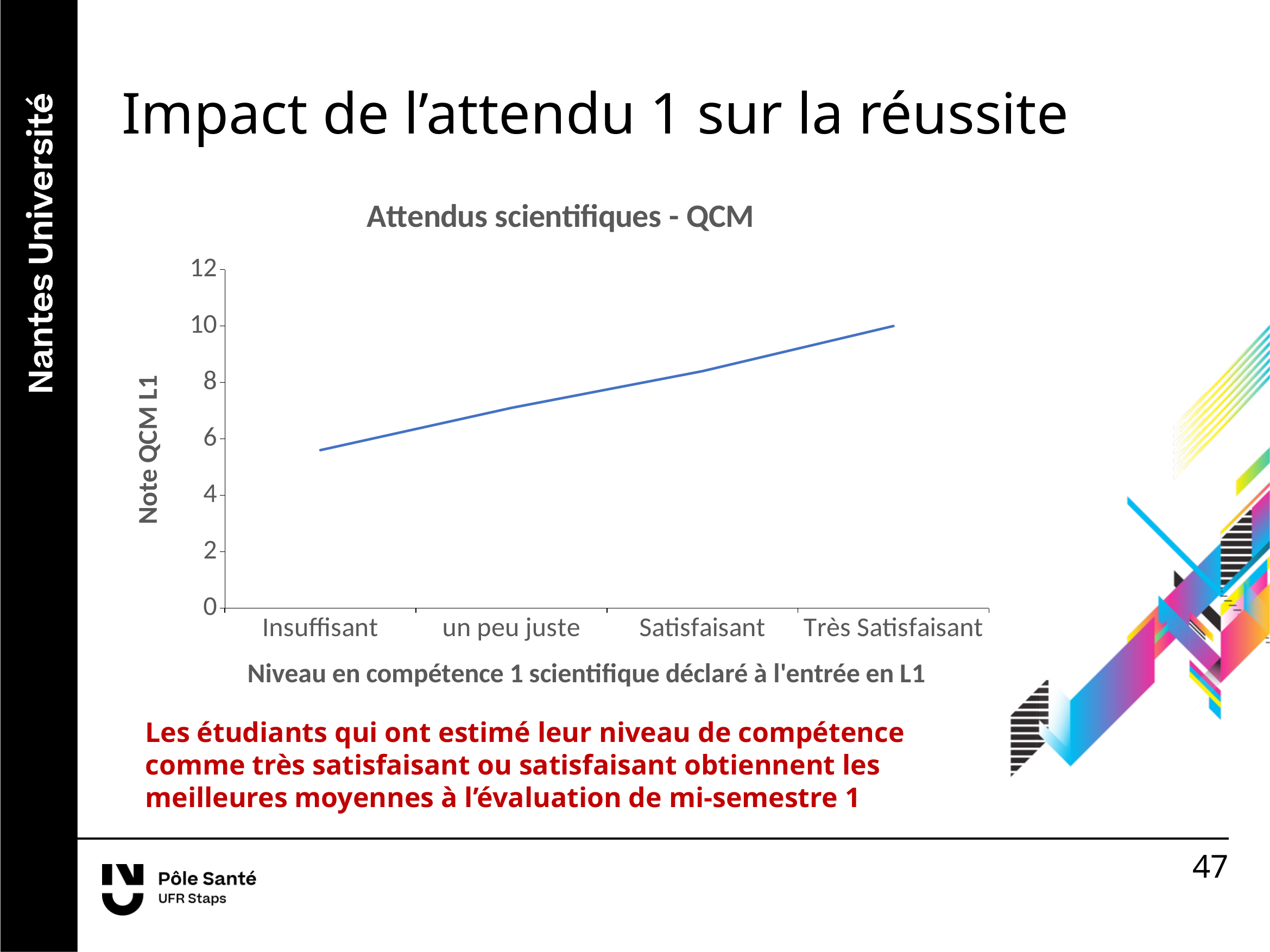
Is the value for Insuffisant greater or less than 6? less Which category has the lowest Note QCM L1? Insuffisant Is the value for Très Satisfaisant greater or less than 8? greater Is the value for un peu juste greater or less than 6? greater Which is larger, the value for Satisfaisant or the value for un peu juste? Satisfaisant Do the values rise or fall from Insuffisant to Très Satisfaisant? rise How many categories are shown on the x axis of the chart? 4 What is the title of the chart? Attendus scientifiques - QCM Which category has the highest Note QCM L1? Très Satisfaisant What type of chart is shown on the slide? line chart What is the label of the y axis? Note QCM L1